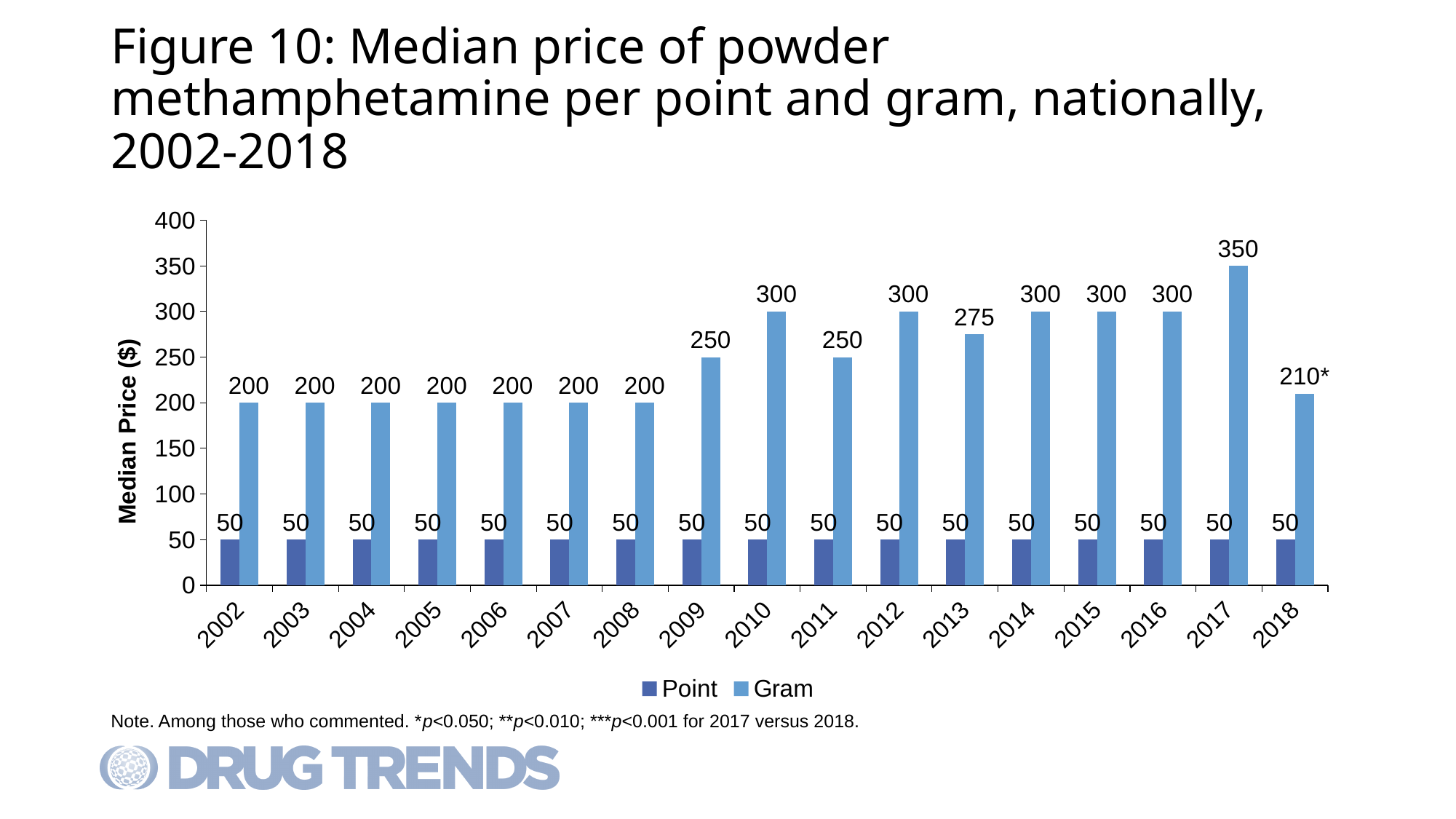
What is the difference between the median price per gram in 2017 and in 2016? 50 How many years are shown on the x axis? 17 What is the label of the y axis? Median Price ($) What is the difference between the Gram and Point values in 2009? 200 What is the median price per point in 2010? 50 What is the median price per gram in 2013? 275 In which year is the median price per gram highest? 2017 Which is larger, the median price per gram in 2011 or in 2012? 2012 What is the median price per gram in 2017? 350 How many series does the legend list? 2 What is the data label shown for the Gram series in 2018? 210* What kind of chart is shown? bar chart